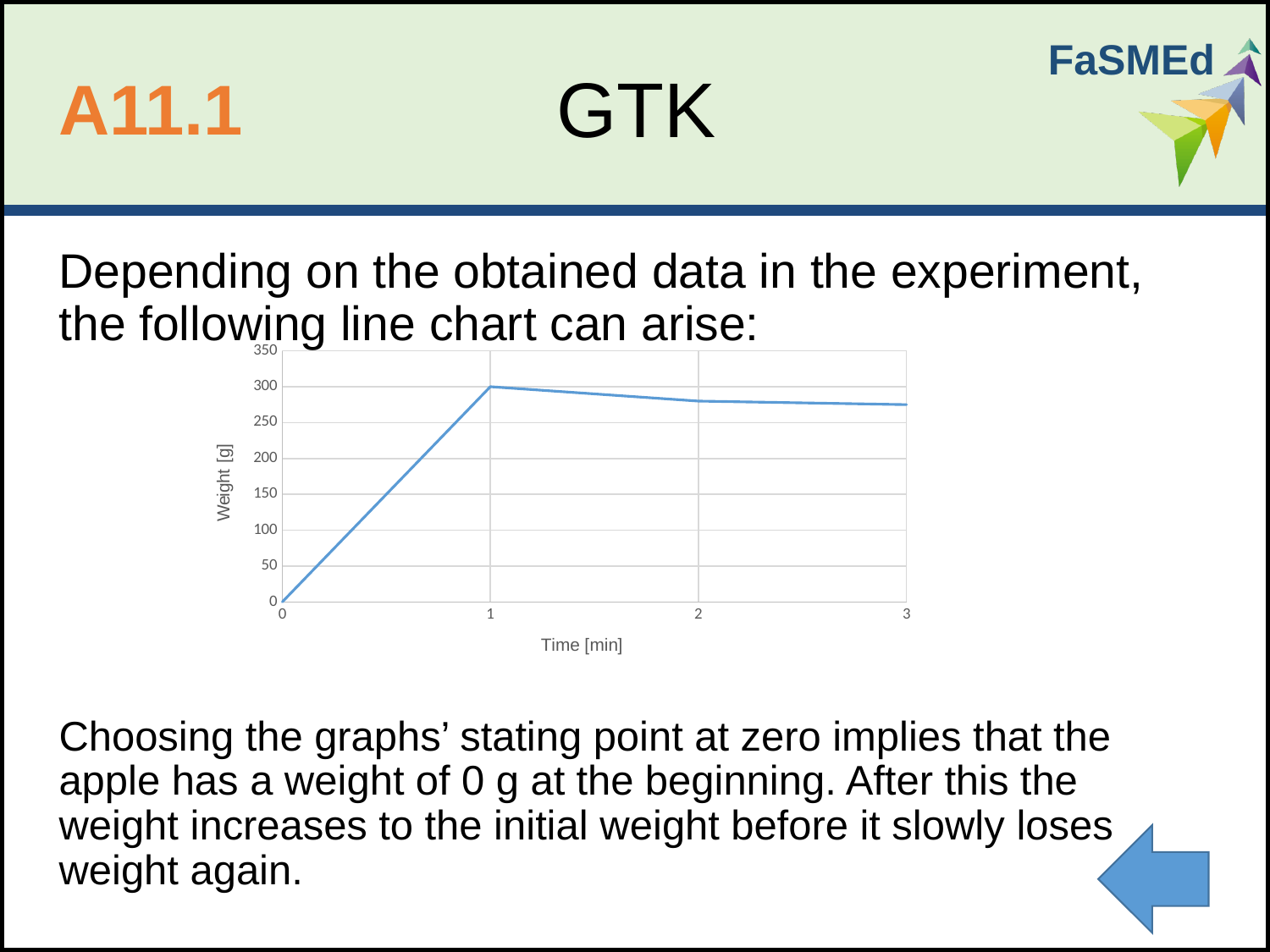
What is the label of the y axis of the chart? Weight [g] Which is larger, the weight at time 1 min or at time 3 min? time 1 min What is the weight at time 0 min? 0 Does the weight rise or fall between time 1 min and time 3 min? fall By how much does the weight increase from time 0 min to time 1 min? 300 What is the weight at time 1 min? 300 At which time is the weight lowest? 0 Is the weight at time 2 min greater or less than 250? greater At which time is the weight highest? 1 What is the label of the x axis of the chart? Time [min] What kind of chart is shown on the slide? line chart Is the weight at time 3 min greater or less than 300? less